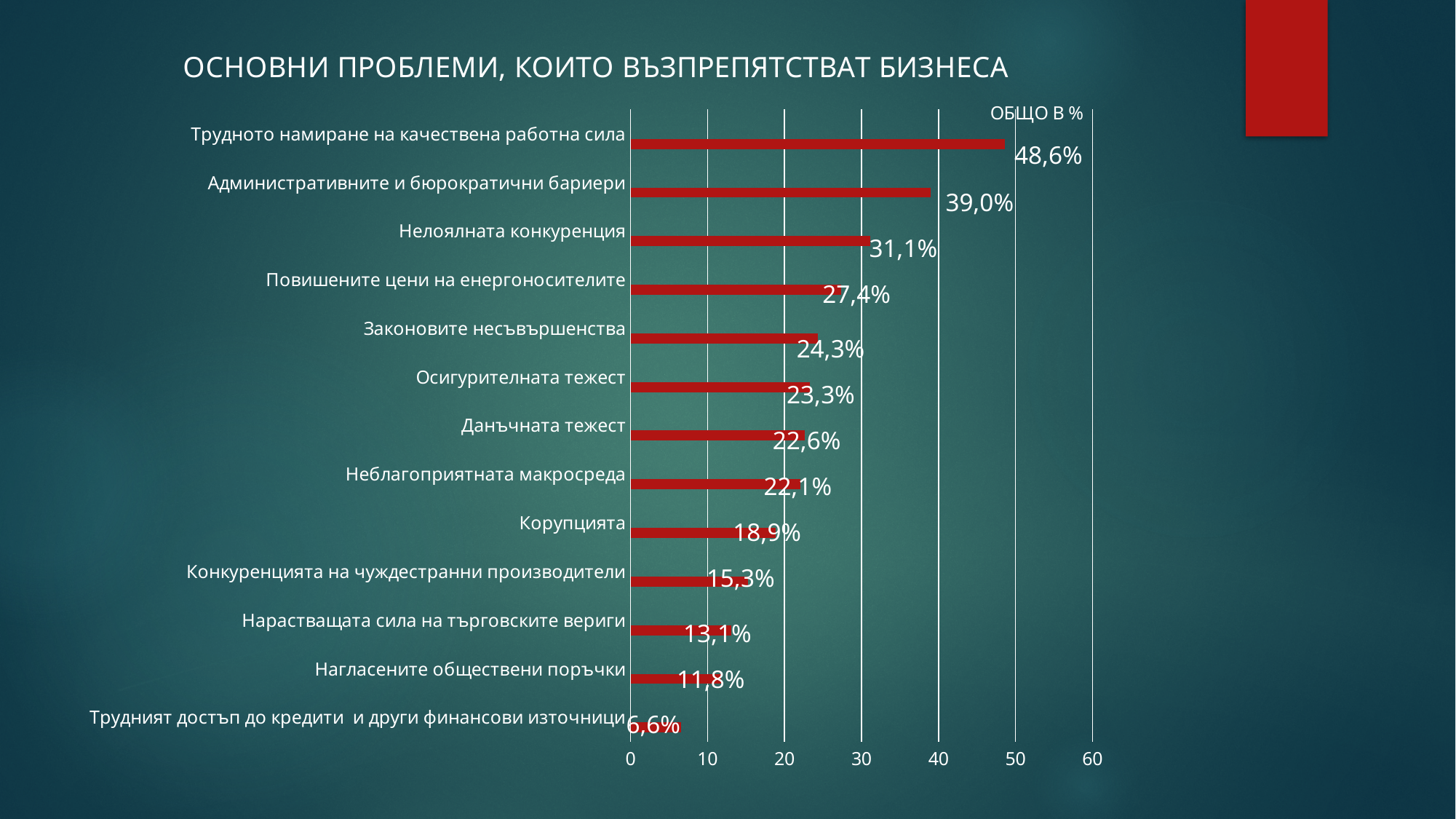
Is the value for Повишените цени на енергоносителите greater or less than 30? less What is the value for Трудното намиране на качествена работна сила? 48,6% What is the title of the chart? ОСНОВНИ ПРОБЛЕМИ, КОИТО ВЪЗПРЕПЯТСТВАТ БИЗНЕСА What is the difference between the values for Административните и бюрократични бариери and Нелоялната конкуренция? 7,9% What kind of chart is shown on the slide? bar chart What is the value for Нелоялната конкуренция? 31,1% How many categories are shown in the chart? 13 What is the label shown at the top right of the chart above the data labels? ОБЩО В % What is the value for Корупцията? 18,9% Which category has the lowest value? Трудният достъп до кредити и други финансови източници Which is larger, the value for Законовите несъвършенства or the value for Данъчната тежест? Законовите несъвършенства Which category has the highest value? Трудното намиране на качествена работна сила